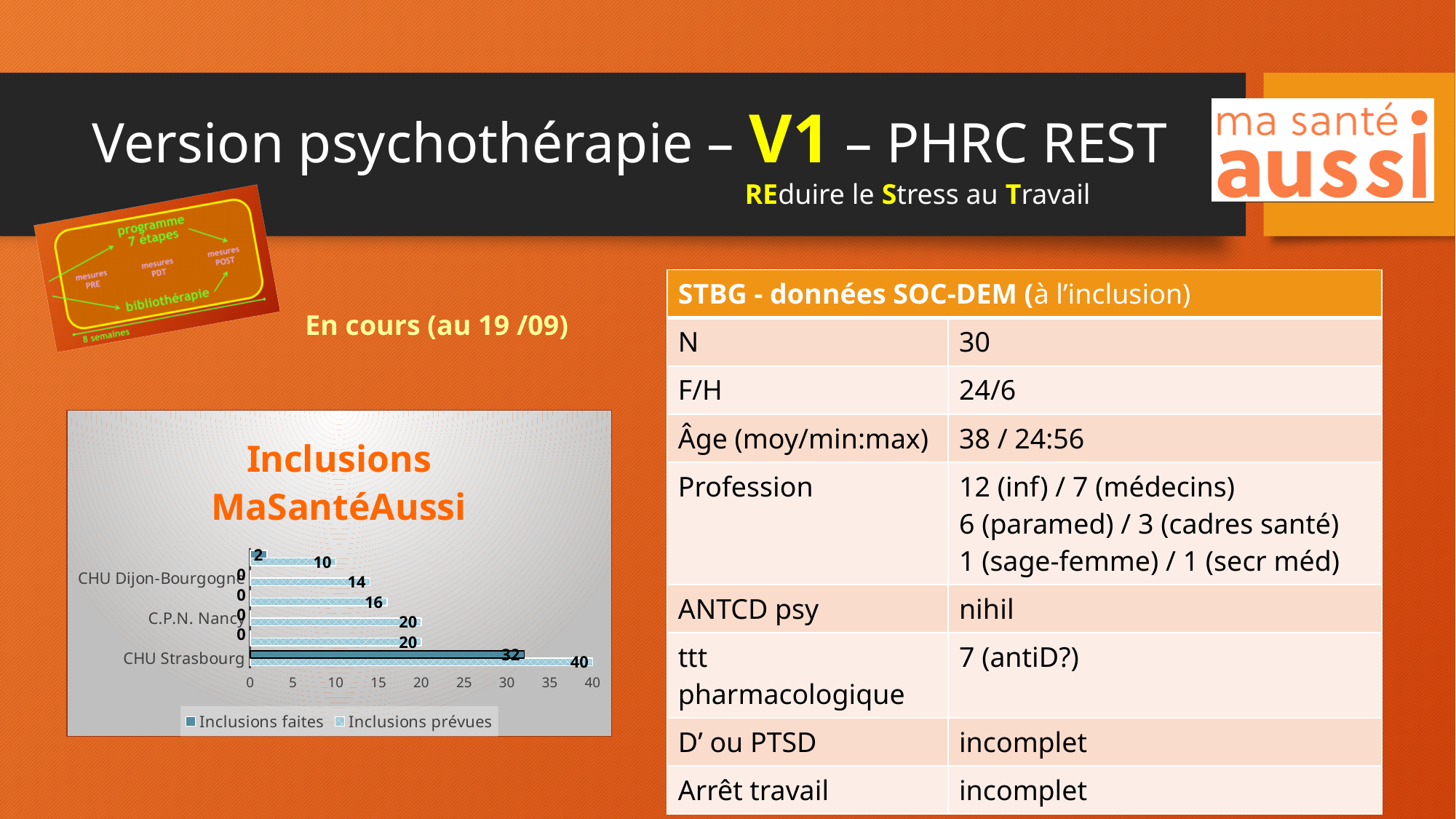
What is the value of Inclusions faites for CHU Strasbourg? 32 What is the difference between Inclusions prévues and Inclusions faites for CHU Strasbourg? 8 What is the value of Inclusions prévues for CHU Strasbourg? 40 What are the two series named in the chart legend? Inclusions faites, Inclusions prévues Is the value of Inclusions faites for CHU Strasbourg greater or less than Inclusions prévues for CHU Dijon-Bourgogne? greater How many series does the chart legend list? 2 Which centre has the highest value of Inclusions faites? CHU Strasbourg What type of chart is shown on the slide? bar chart What is the value of Inclusions faites for C.P.N. Nancy? 0 What is the value of Inclusions prévues for CHU Dijon-Bourgogne? 14 What is the title of the chart? Inclusions MaSantéAussi Which centre has the highest value of Inclusions prévues? CHU Strasbourg